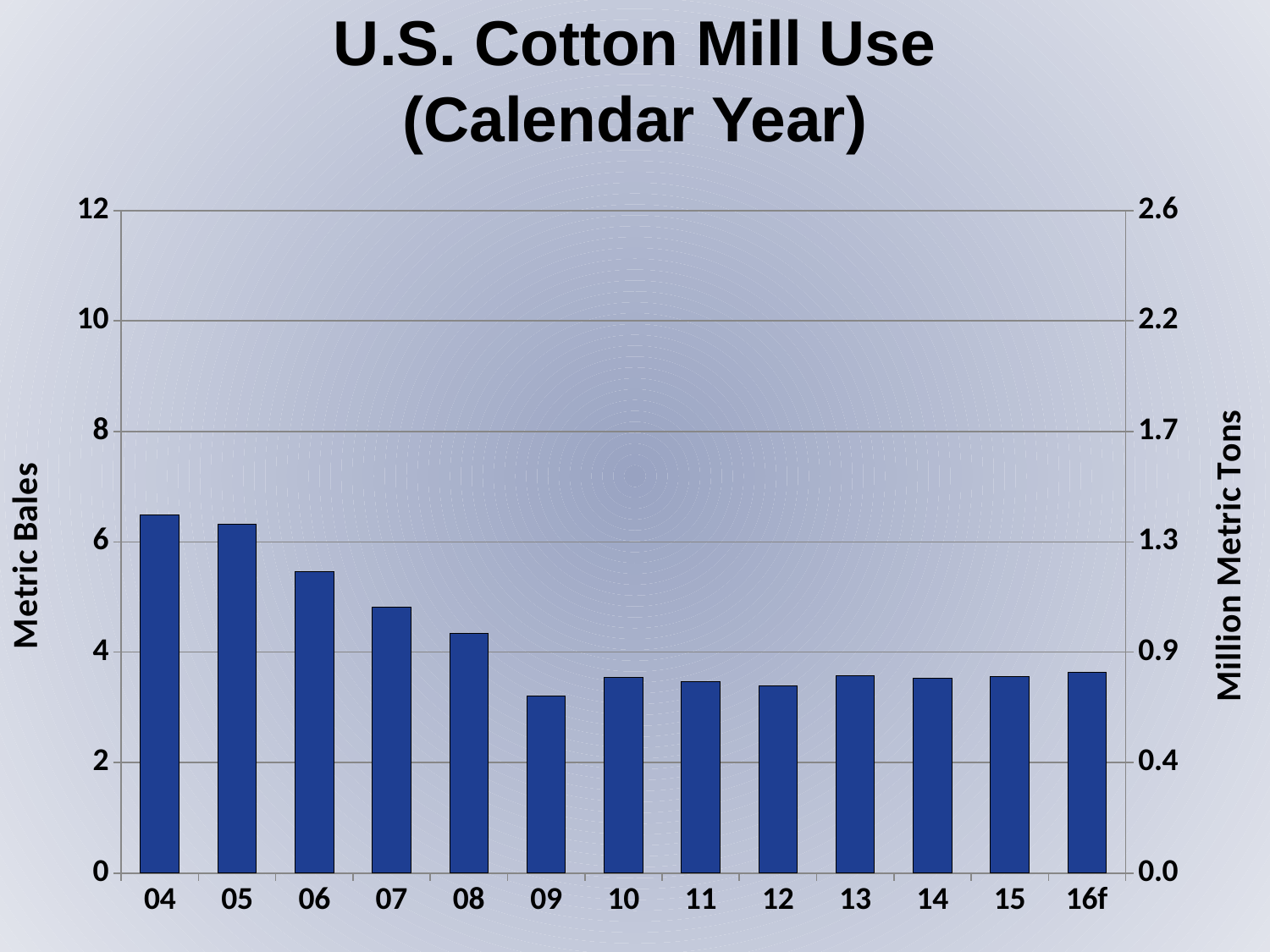
Is the value for 06 greater or less than 6 on the Metric Bales axis? less What is the title of the chart? U.S. Cotton Mill Use (Calendar Year) What kind of chart is shown on the slide? bar chart Which year has the highest cotton mill use? 04 Do the values rise or fall from 04 to 09? fall Which year has the lowest cotton mill use? 09 How many years (categories) are plotted on the x axis? 13 Is the value for 04 greater or less than 6 on the Metric Bales axis? greater Is the value for 09 greater or less than 4 on the Metric Bales axis? less What is the label of the right-hand vertical axis? Million Metric Tons Which is larger, the value for 06 or the value for 08? 06